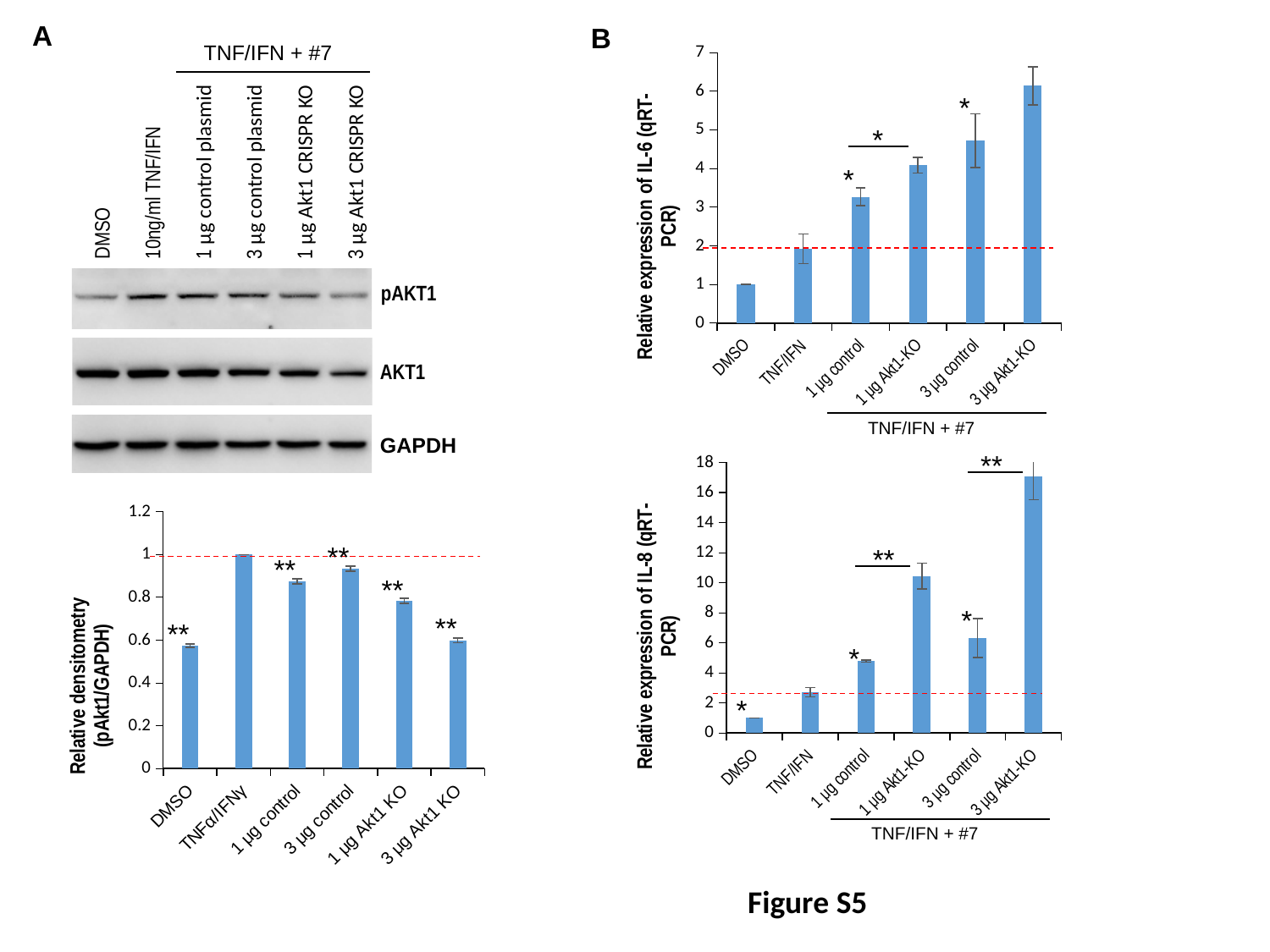
In the IL-8 chart (bottom right), which is larger, the value for 1 µg Akt1-KO or the value for 3 µg control? 1 µg Akt1-KO In the IL-6 chart (top right), which category has the lowest relative expression? DMSO What kind of chart is the relative densitometry chart (bottom left)? bar chart In the relative densitometry chart (bottom left), is the value for 1 µg control greater or less than 0.8? greater In the relative densitometry chart (bottom left), which category has the highest value? TNFα/IFNγ In the IL-8 chart (bottom right), is the value for TNF/IFN greater or less than 4? less In the IL-6 chart (top right), which is larger, the value for 1 µg control or the value for 1 µg Akt1-KO? 1 µg Akt1-KO In the IL-6 chart (top right), is the value for 1 µg control greater or less than 3? greater In the IL-6 chart (top right), which category has the highest relative expression? 3 µg Akt1-KO In the IL-8 chart (bottom right), which category has the highest relative expression? 3 µg Akt1-KO In the IL-6 chart (top right), how many categories are plotted on the x axis? 6